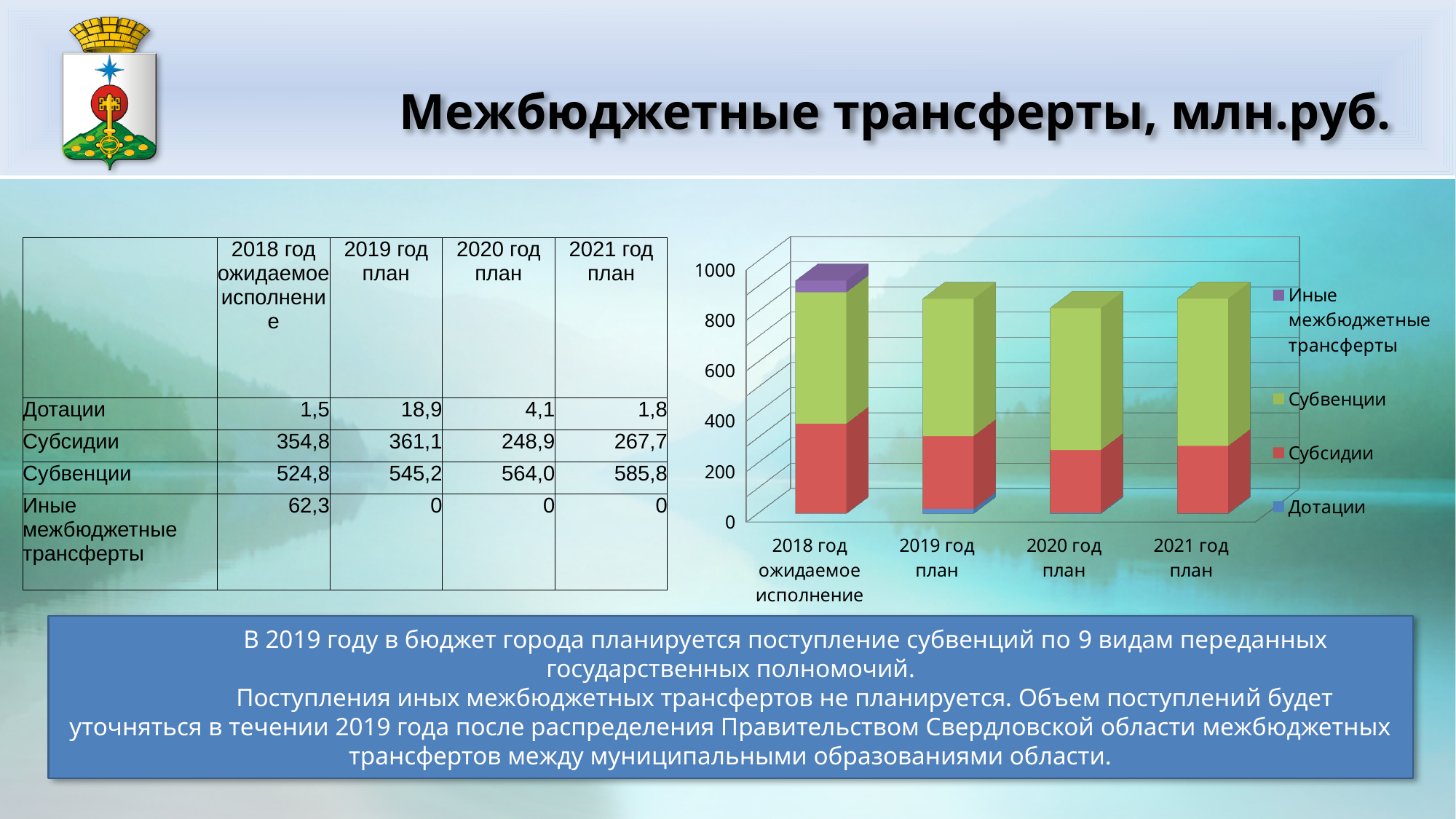
What is the value of Субвенции for 2021 год план? 585,8 What kind of chart is shown on the slide? stacked bar chart Do the values of Субвенции rise or fall from 2018 to 2021 along the x axis? rise How many series does the chart legend list? 4 How many year categories are shown on the x axis of the chart? 4 Which is larger: Субсидии for 2019 год план or Субсидии for 2020 год план? 2019 год план What is the value of Субсидии for 2018 год ожидаемое исполнение? 354,8 Is the total height of the stacked bar for 2020 год план greater or less than 1000? less What is the total of the stacked bar for 2018 год ожидаемое исполнение? 943,4 In which year is the value of Субвенции the highest? 2021 год план In which year is the value of Субсидии the lowest? 2020 год план By how much does Субвенции for 2021 год план exceed Субвенции for 2018 год ожидаемое исполнение? 61,0